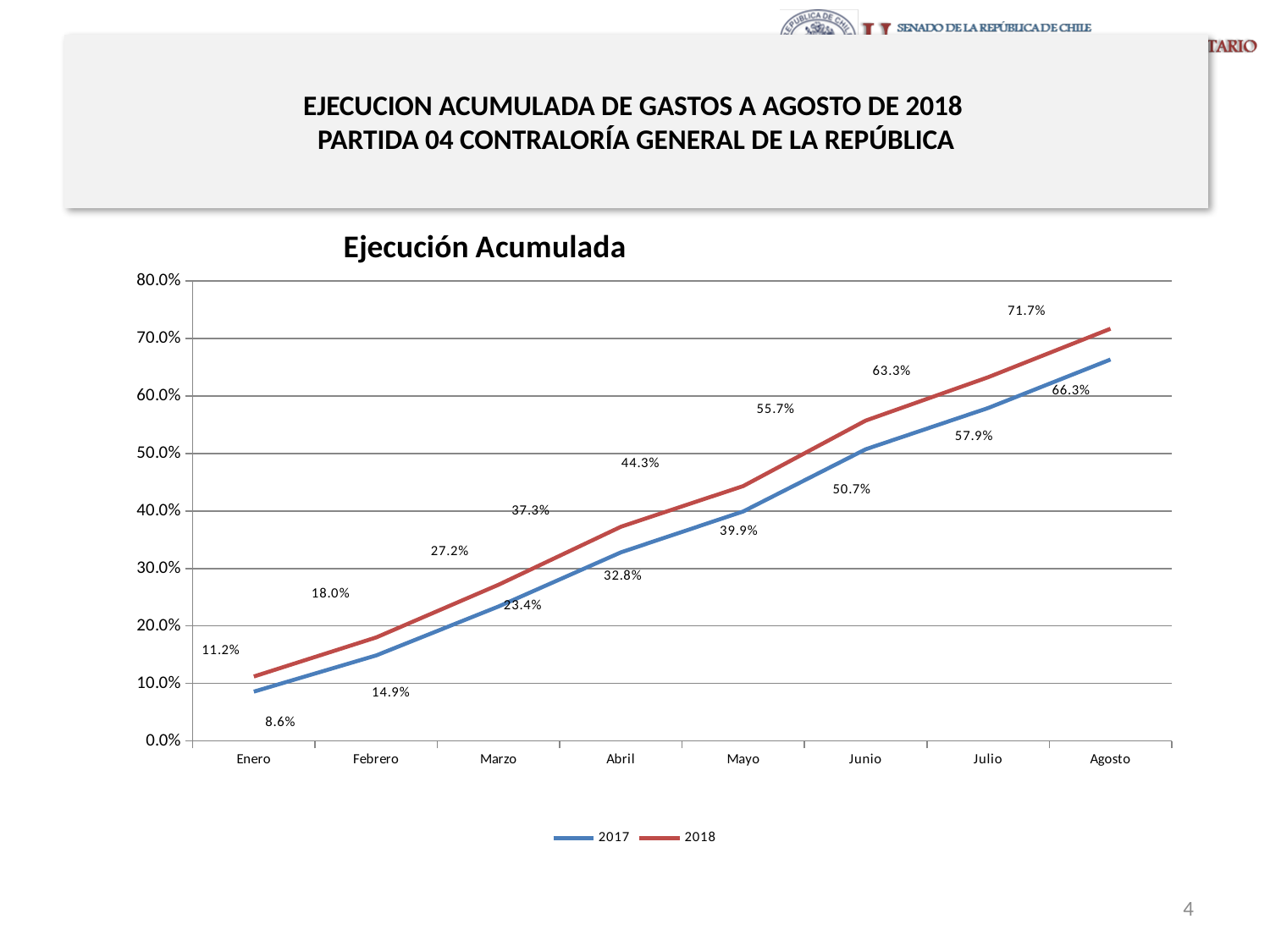
What is the value for 2017 in Enero? 8.6% What is the value for 2018 in Agosto? 71.7% Which series has the larger value in Mayo, 2017 or 2018? 2018 How many months are shown on the x axis? 8 How many series does the legend list? 2 What kind of chart is shown? line chart In which month is the 2018 series highest? Agosto In which month is the 2017 series lowest? Enero Do the values for 2017 rise or fall from Enero to Agosto? rise What is the value for 2018 in Abril? 37.3% What is the value for 2017 in Junio? 50.7% What is the difference between the 2018 and 2017 values in Agosto? 5.4%